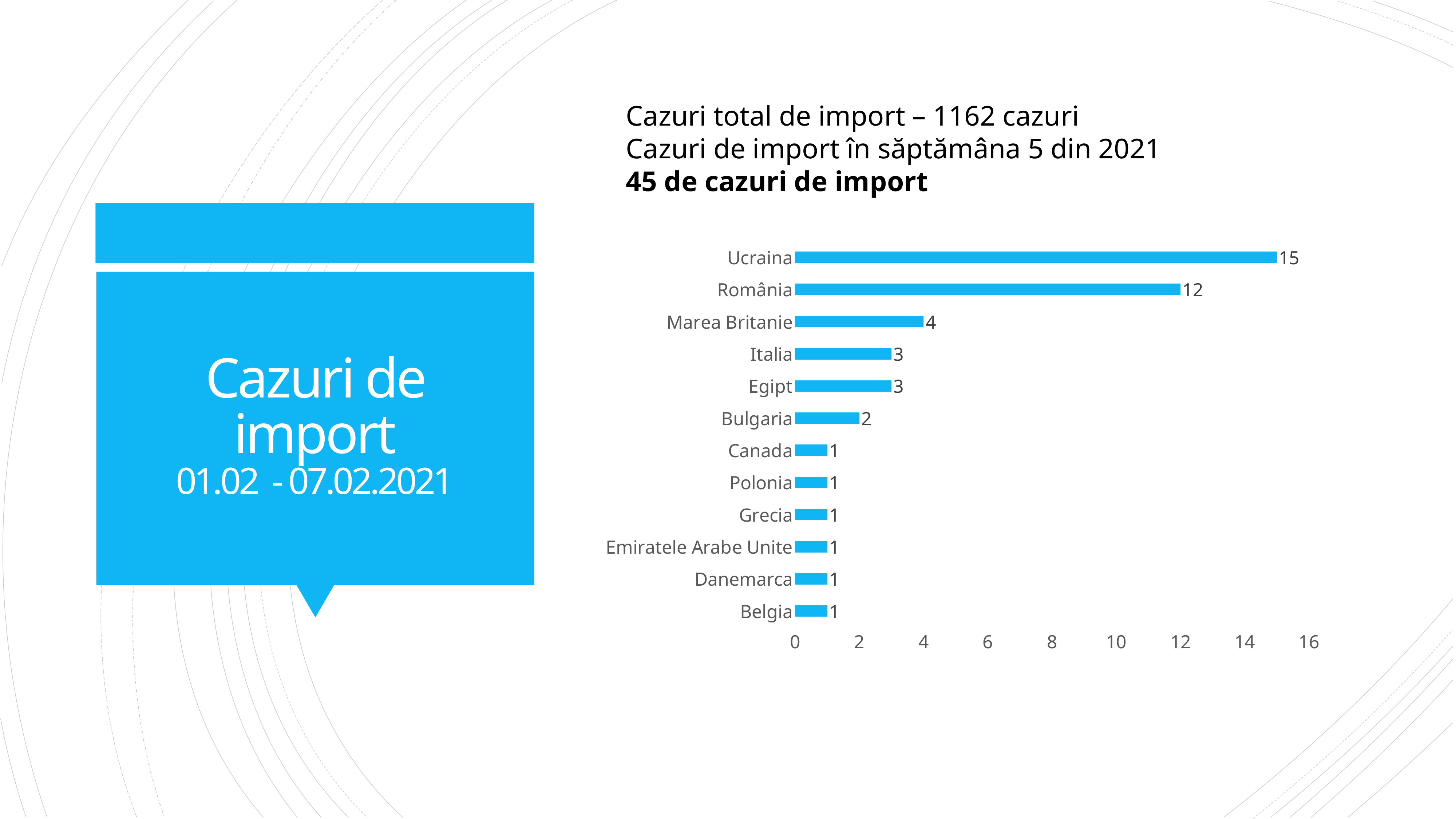
What is the highest value shown on the x axis? 16 What kind of chart is shown on the slide? bar chart What is the value for Ucraina? 15 What is the value for Marea Britanie? 4 How many categories are shown in the chart? 12 What is the value for România? 12 Is the value for România greater or less than 10? greater Which category has the highest value? Ucraina What is the value for Bulgaria? 2 What is the difference between the values for Ucraina and România? 3 Which is larger, the value for Marea Britanie or the value for Italia? Marea Britanie How many categories have a value of 1? 6